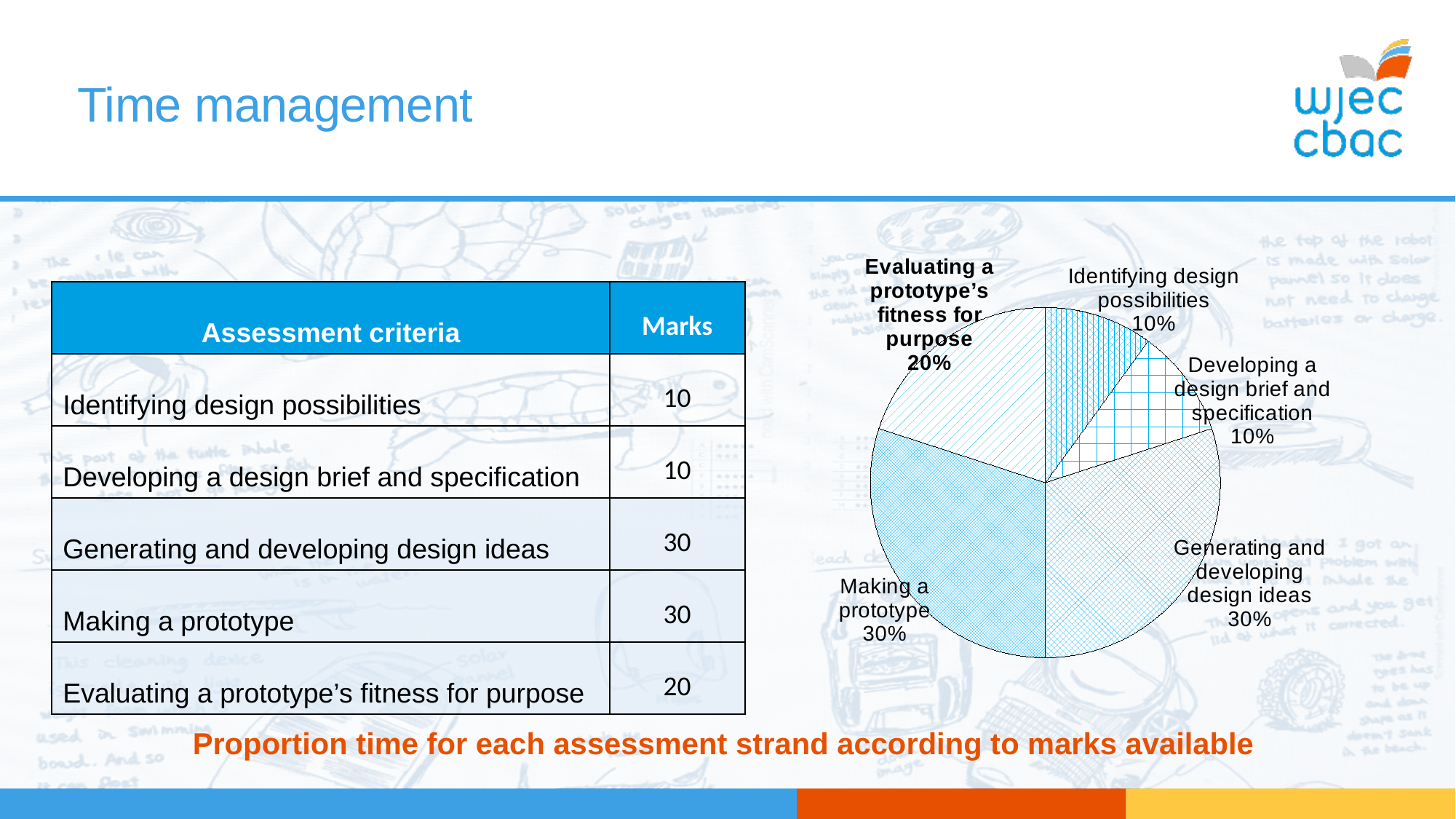
What percentage of the pie chart is 'Making a prototype'? 30% What is the difference in percentage points between the 'Generating and developing design ideas' slice and the 'Evaluating a prototype's fitness for purpose' slice? 10 What percentage of the pie chart is 'Identifying design possibilities'? 10% What percentage of the pie chart is 'Developing a design brief and specification'? 10% Which slice is larger in the pie chart: 'Making a prototype' or 'Evaluating a prototype's fitness for purpose'? Making a prototype What is the difference in percentage points between the 'Making a prototype' slice and the 'Developing a design brief and specification' slice? 20 What is the caption printed in orange below the pie chart? Proportion time for each assessment strand according to marks available What type of chart is shown on the slide? pie chart Which slice is larger in the pie chart: 'Evaluating a prototype's fitness for purpose' or 'Identifying design possibilities'? Evaluating a prototype's fitness for purpose How many slices does the pie chart have? 5